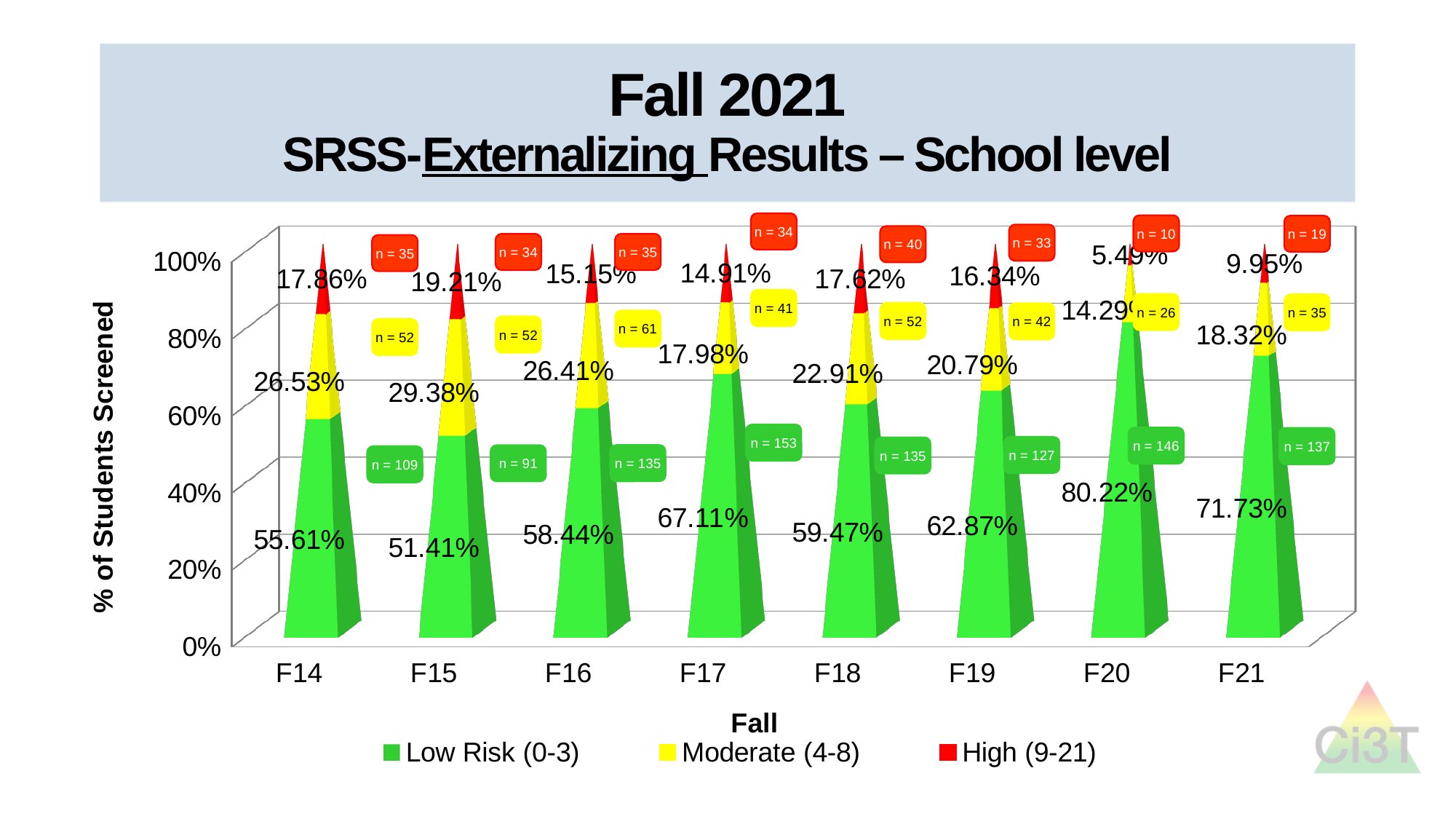
What is the Moderate (4-8) percentage for F15? 29.38% What is the High (9-21) percentage for F17? 14.91% What is the label on the y axis of the chart? % of Students Screened Which fall has the highest Low Risk (0-3) percentage? F20 What kind of chart is shown on the slide? Stacked bar chart What is the Low Risk (0-3) percentage for F20? 80.22% Which is larger, the Moderate (4-8) percentage for F14 or for F16? F14 (26.53%) How many series does the legend list? 3 How many fall semesters are shown on the x axis? 8 How many students were in the Low Risk (0-3) group for F17 (the n value)? n = 153 Which fall has the lowest High (9-21) percentage? F20 What is the difference between the Low Risk (0-3) percentages for F20 and F21? 8.49 percentage points